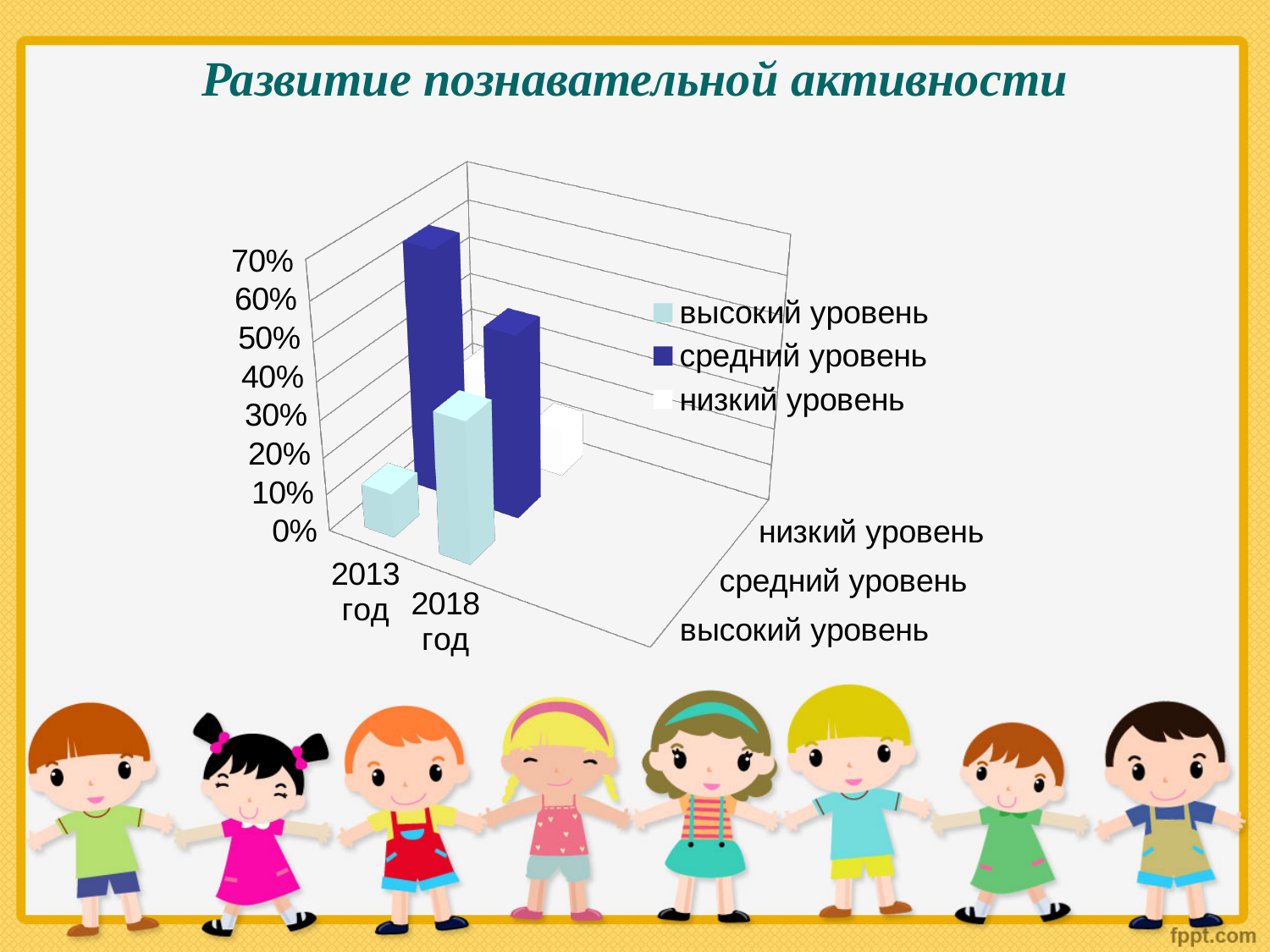
What is the title of the slide containing the chart? Развитие познавательной активности Is the value for высокий уровень in 2013 год greater or less than 30%? less Which is larger for средний уровень: the value for 2013 год or for 2018 год? 2013 год Is the value for средний уровень in 2018 год greater or less than 30%? greater Which series is shown in dark blue in the chart legend? средний уровень Which level has the highest value in 2013 год? средний уровень Does the value for высокий уровень rise or fall from 2013 год to 2018 год? rise How many series does the chart legend list? 3 What kind of chart is shown on the slide? bar chart How many year categories are shown on the x axis of the chart? 2 Is the value for средний уровень in 2013 год greater or less than 40%? greater Which is larger for высокий уровень: the value for 2013 год or for 2018 год? 2018 год